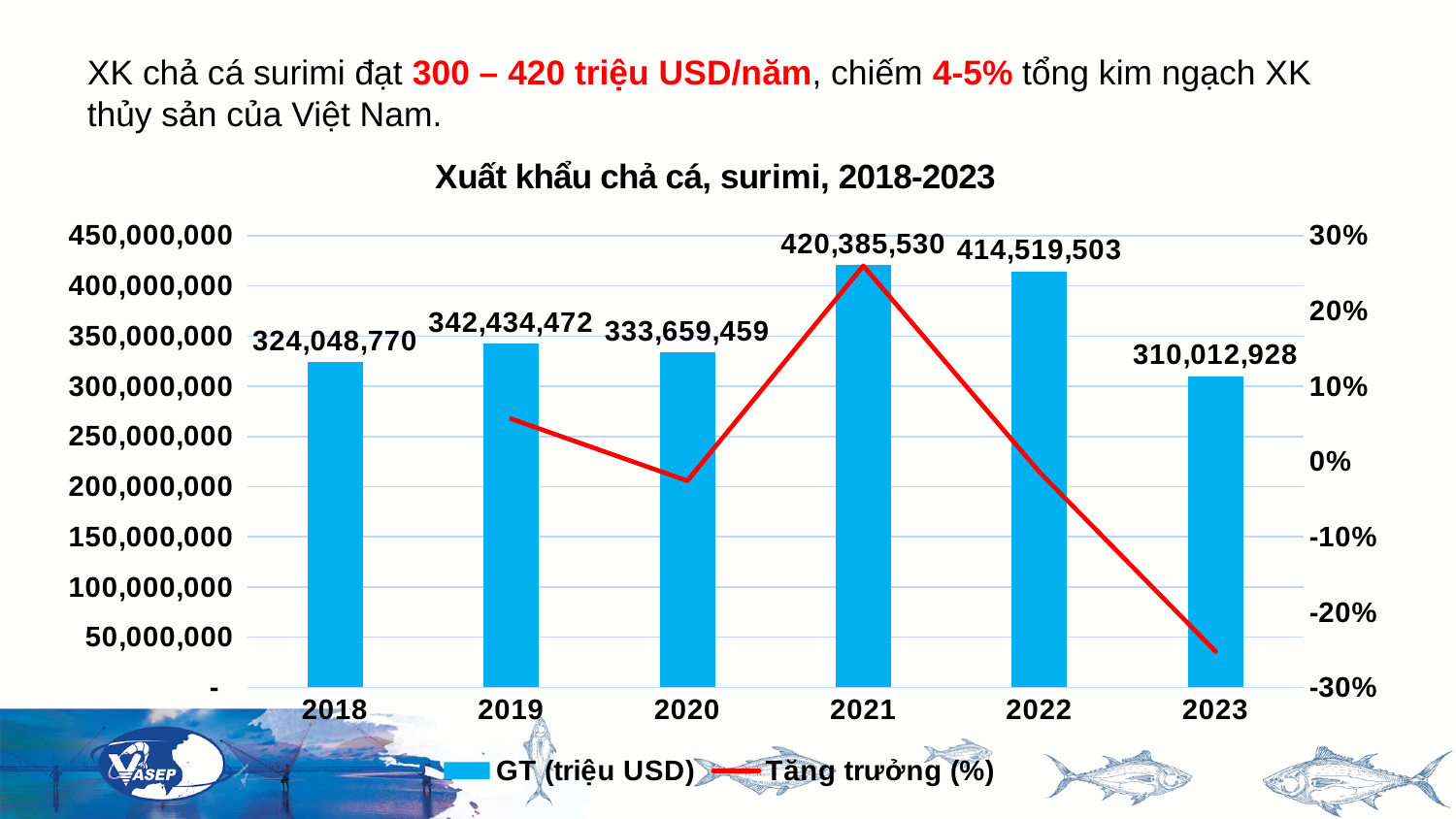
How many years are shown on the x axis? 6 Which year has a larger GT value, 2019 or 2020? 2019 Is the Tăng trưởng (%) value for 2023 greater or less than -20%? less What is the GT (triệu USD) value for 2021? 420,385,530 Which year has the lowest GT (triệu USD) value? 2023 How many series does the legend list? 2 Is the Tăng trưởng (%) value for 2021 greater or less than 20%? greater What is the GT (triệu USD) value for 2018? 324,048,770 Which year has the highest GT (triệu USD) value? 2021 What is the GT (triệu USD) value for 2023? 310,012,928 Do the GT (triệu USD) bars rise or fall from 2021 to 2023? fall What is the difference between the GT values for 2021 and 2022? 5,866,027